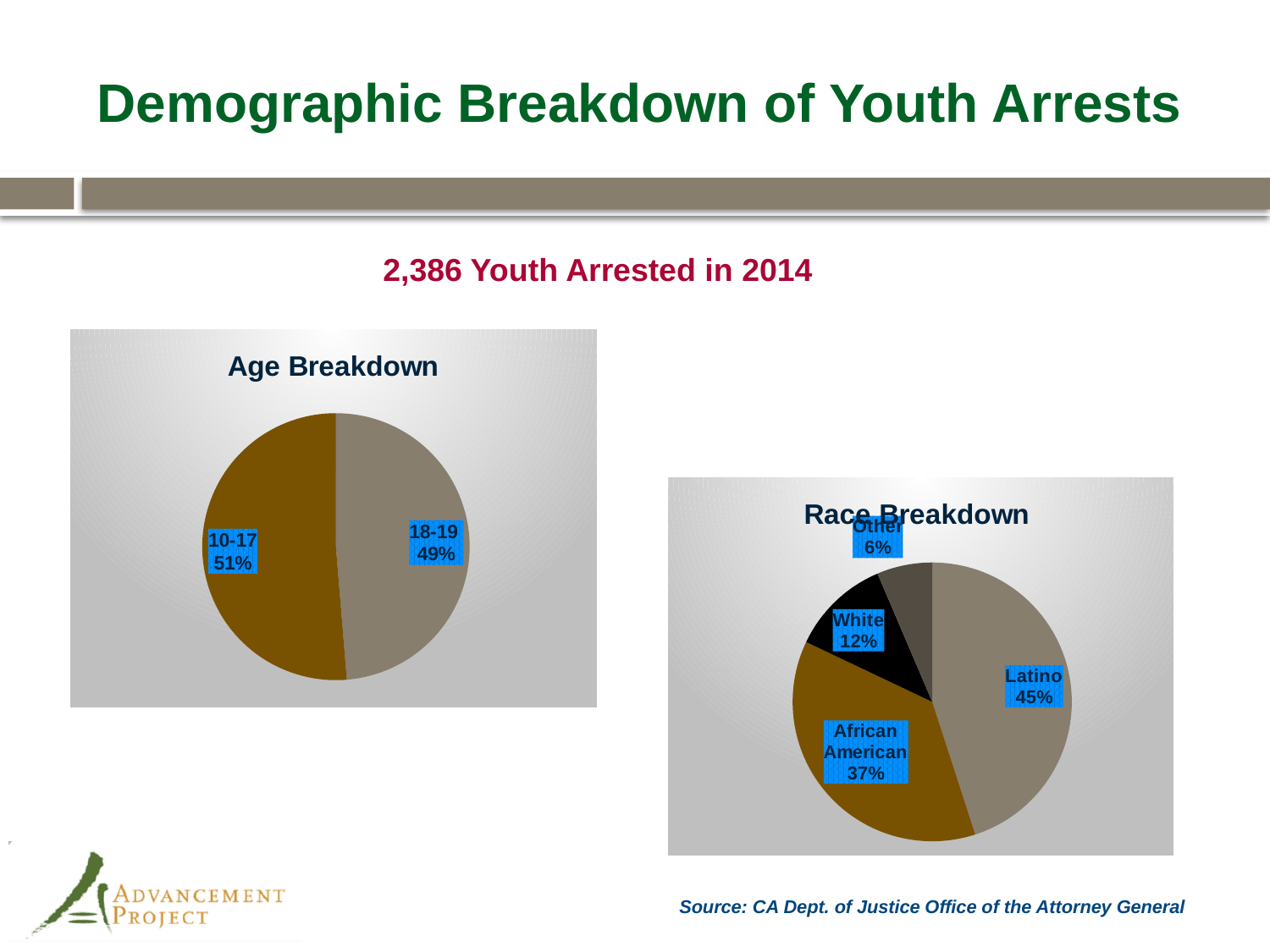
In the Race Breakdown chart, which group has the largest share? Latino In the Age Breakdown chart, what kind of chart is shown? Pie chart In the Age Breakdown chart, what is the difference in percentage points between the 10-17 and 18-19 slices? 2 percentage points In the Age Breakdown chart, what share of youth arrests is for ages 10-17? 51% In the Race Breakdown chart, what is the difference in percentage points between the Latino and African American slices? 8 percentage points In the Race Breakdown chart, what share of youth arrests is African American? 37% In the Race Breakdown chart, what share of youth arrests is Latino? 45% In the Age Breakdown chart, how many slices does the pie have? 2 In the Race Breakdown chart, which group has the smallest share? Other In the Age Breakdown chart, what share of youth arrests is for ages 18-19? 49% In the Race Breakdown chart, how many slices does the pie have? 4 In the Race Breakdown chart, what share of youth arrests is White? 12%